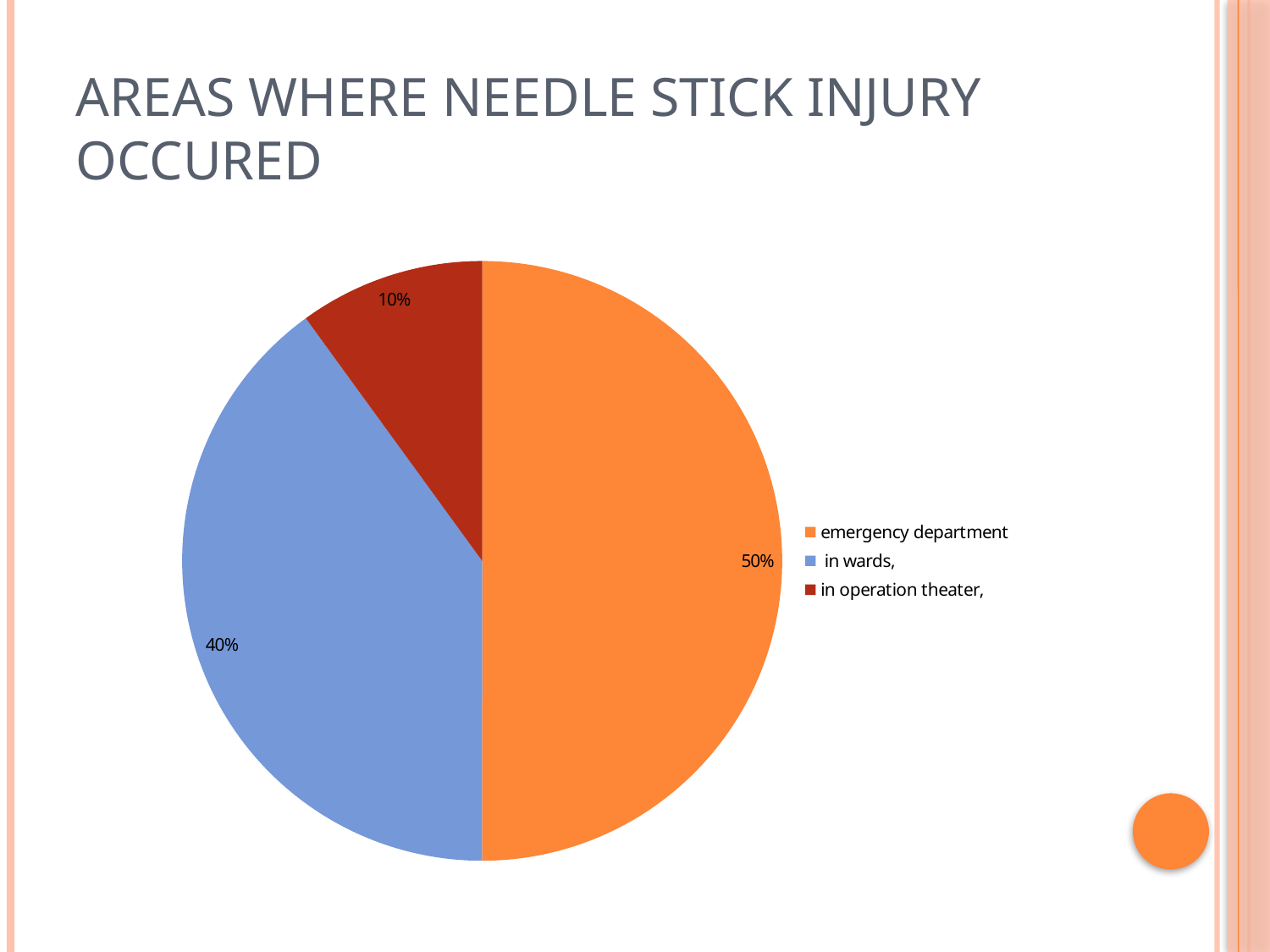
What is the difference in percentage points between the emergency department and in wards? 10 What type of chart is shown on the slide? pie chart How many categories does the pie chart show? 3 Which has a larger share: in wards or in operation theater? in wards What share of needle stick injuries occurred in operation theater? 10% What is the title of the slide? AREAS WHERE NEEDLE STICK INJURY OCCURED What share of needle stick injuries occurred in the emergency department? 50% What colour is the slice for in wards? blue Which area has the largest share of needle stick injuries? emergency department Which area has the smallest share of needle stick injuries? in operation theater What is the difference in percentage points between in wards and in operation theater? 30 What share of needle stick injuries occurred in wards? 40%